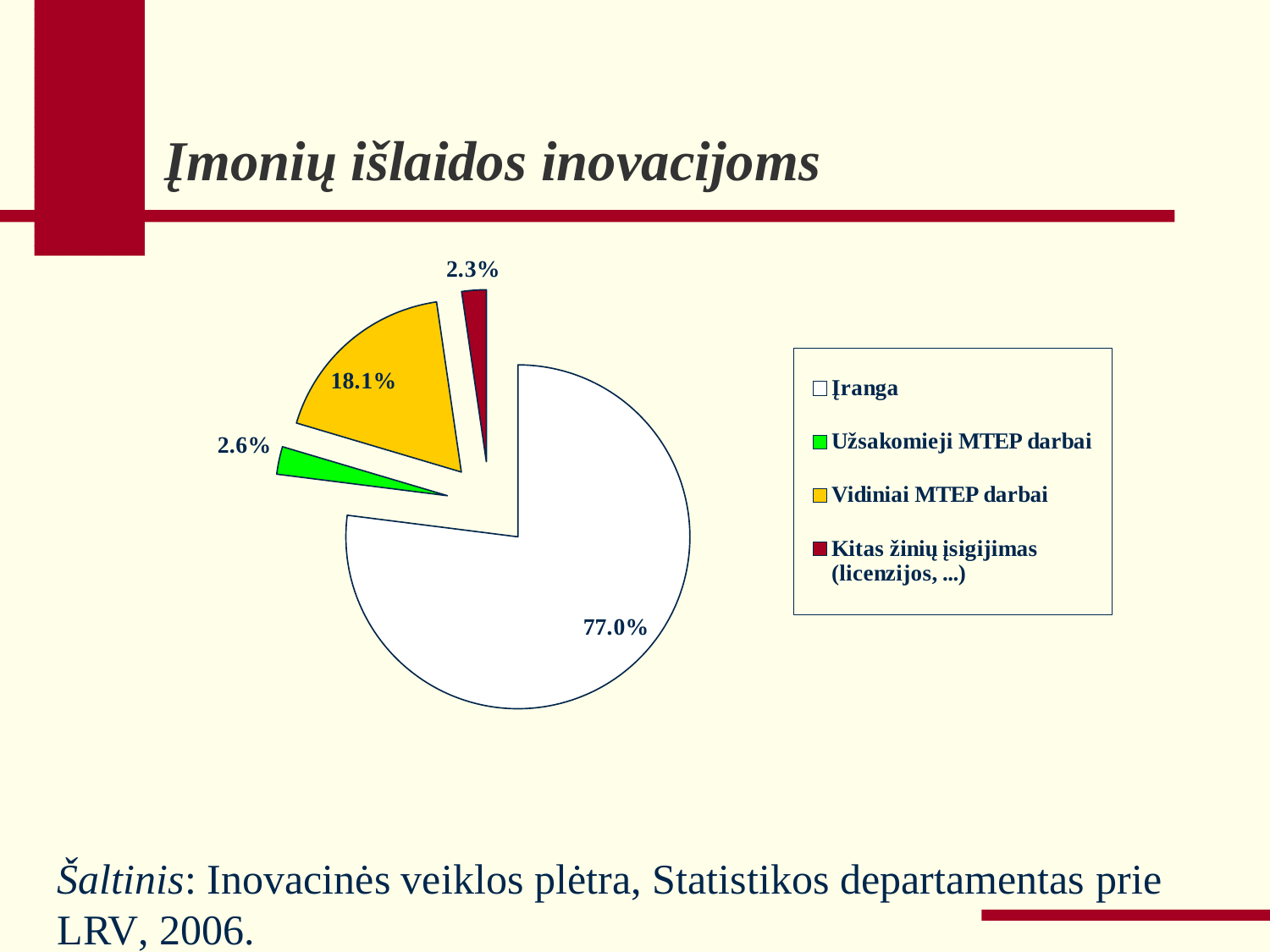
Which is larger, the share for Vidiniai MTEP darbai or the share for Užsakomieji MTEP darbai? Vidiniai MTEP darbai What type of chart is shown on the slide? Pie chart What is the value shown for Vidiniai MTEP darbai? 18.1% Which category has the smallest share of the pie? Kitas žinių įsigijimas (licenzijos, ...) What is the title of the slide containing the chart? Įmonių išlaidos inovacijoms What is the value shown for Užsakomieji MTEP darbai? 2.6% What is the difference in percentage points between Įranga and Vidiniai MTEP darbai? 58.9 What share of the pie does Įranga account for? 77.0% What is the difference in percentage points between Užsakomieji MTEP darbai and Kitas žinių įsigijimas (licenzijos, ...)? 0.3 What is the value shown for Kitas žinių įsigijimas (licenzijos, ...)? 2.3% Which category has the largest share of the pie? Įranga How many categories does the legend list? 4